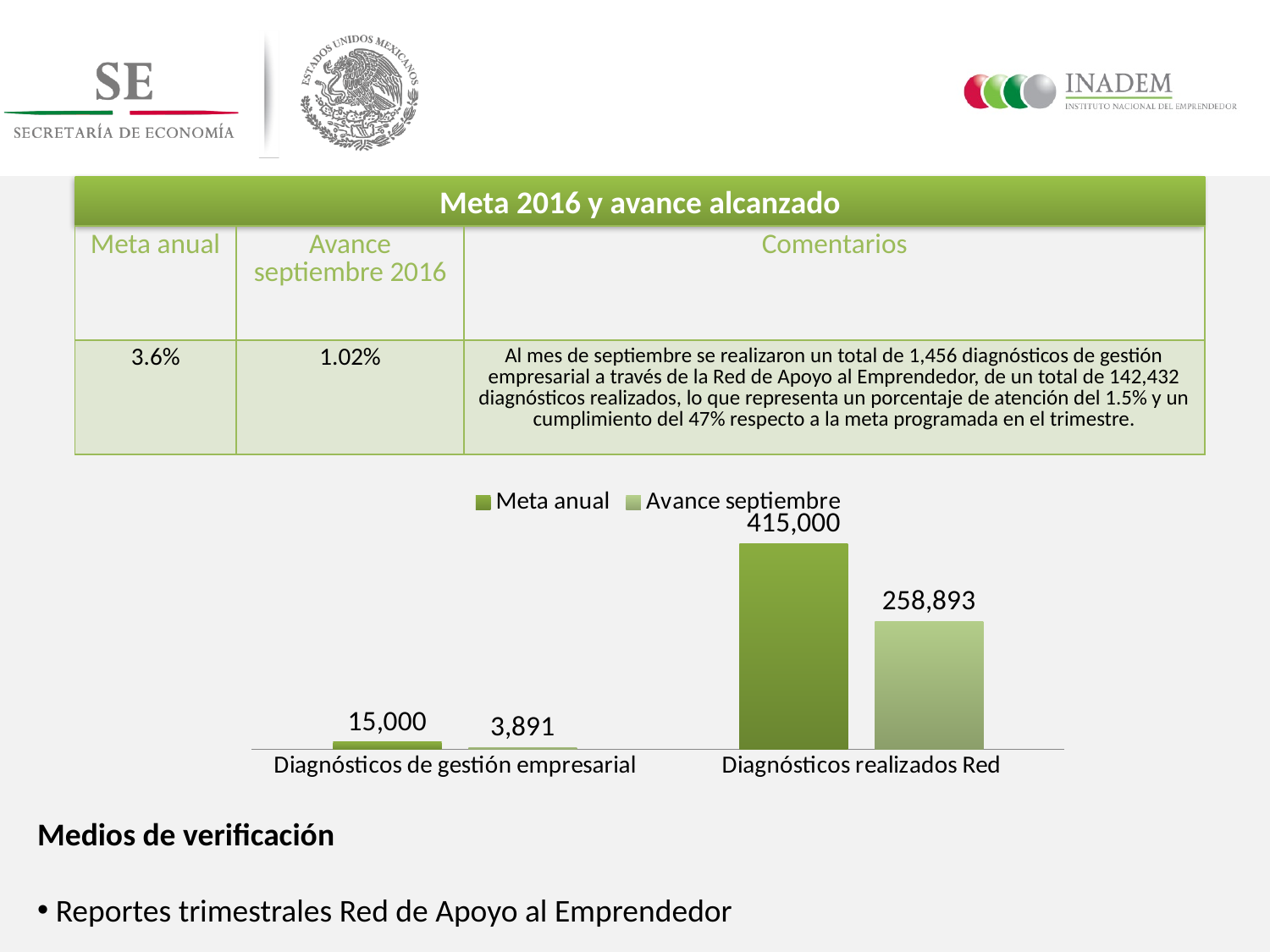
Which category has the lowest Avance septiembre value? Diagnósticos de gestión empresarial Which category has the highest Meta anual value? Diagnósticos realizados Red What is the Avance septiembre value for Diagnósticos de gestión empresarial? 3,891 What kind of chart is shown on the slide? Bar chart What is the Meta anual value for Diagnósticos de gestión empresarial? 15,000 What is the difference between the Meta anual and Avance septiembre values for Diagnósticos de gestión empresarial? 11,109 What is the difference between the Meta anual and Avance septiembre values for Diagnósticos realizados Red? 156,107 How many categories are shown on the x axis of the chart? 2 What is the Avance septiembre value for Diagnósticos realizados Red? 258,893 What is the Meta anual value for Diagnósticos realizados Red? 415,000 Which is larger for Diagnósticos realizados Red: Meta anual or Avance septiembre? Meta anual How many series does the chart legend list? 2